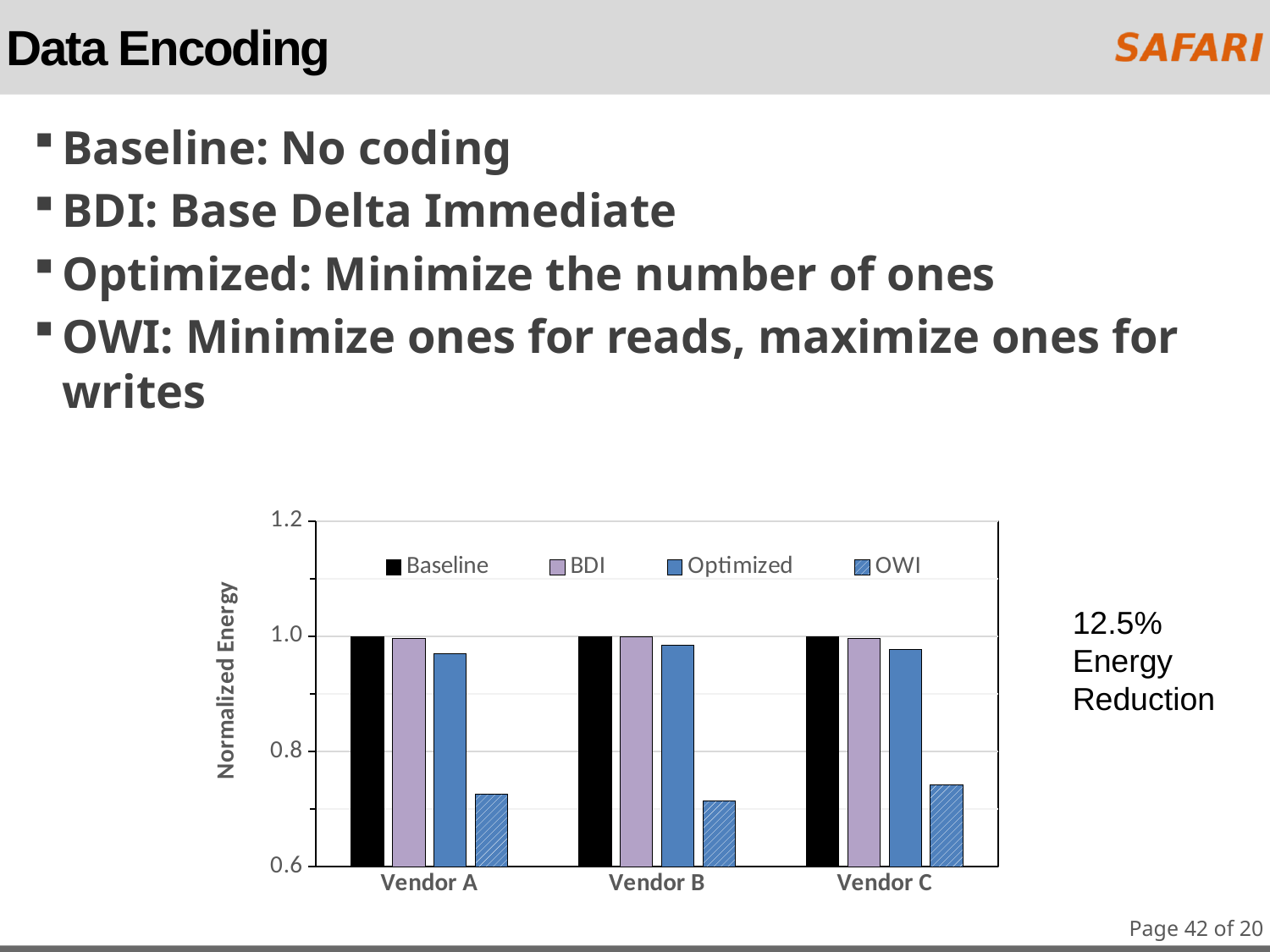
Is the Optimized value for Vendor B greater or less than 0.8? greater What is the Normalized Energy value of the Baseline bar for Vendor A? 1.0 Is the OWI value for Vendor A greater or less than 0.8? less How many series does the chart's legend list? 4 What is the title of the chart's y axis? Normalized Energy How many vendor categories are shown on the x axis of the chart? 3 What is the Normalized Energy value of the Baseline bar for Vendor C? 1.0 Is the BDI value for Vendor C greater or less than 0.8? greater For Vendor C, which is larger: the Optimized value or the OWI value? Optimized What kind of chart is shown on the slide? bar chart Which series has the lowest Normalized Energy for Vendor B? OWI Which series in the legend is drawn with a hatched pattern? OWI